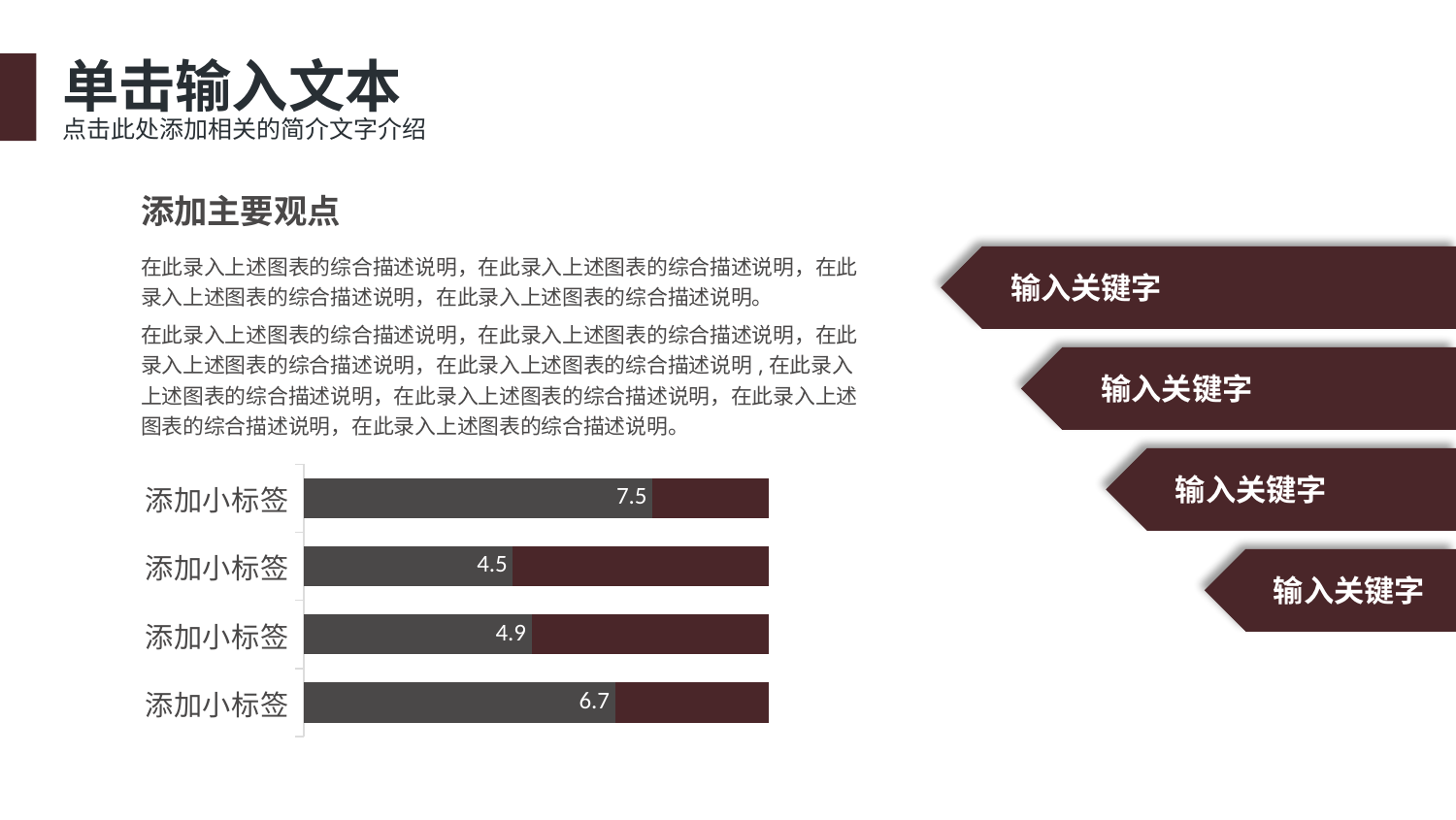
Which bar has the highest value in the chart? the top bar (7.5) How many bars are plotted in the chart? 4 What type of chart is shown on the slide? bar chart What is the value of the top bar in the chart? 7.5 What is the value of the bottom bar in the chart? 6.7 Which bar has the lowest value in the chart? the second bar from the top (4.5) What is the value of the second bar from the top in the chart? 4.5 What is the difference between the top bar's value and the bottom bar's value? 0.8 What is the difference between the third bar's value and the second bar's value? 0.4 What is the value of the third bar from the top in the chart? 4.9 Which is larger, the value of the top bar or the value of the bottom bar? the top bar What label is shown for each category in the chart? 添加小标签